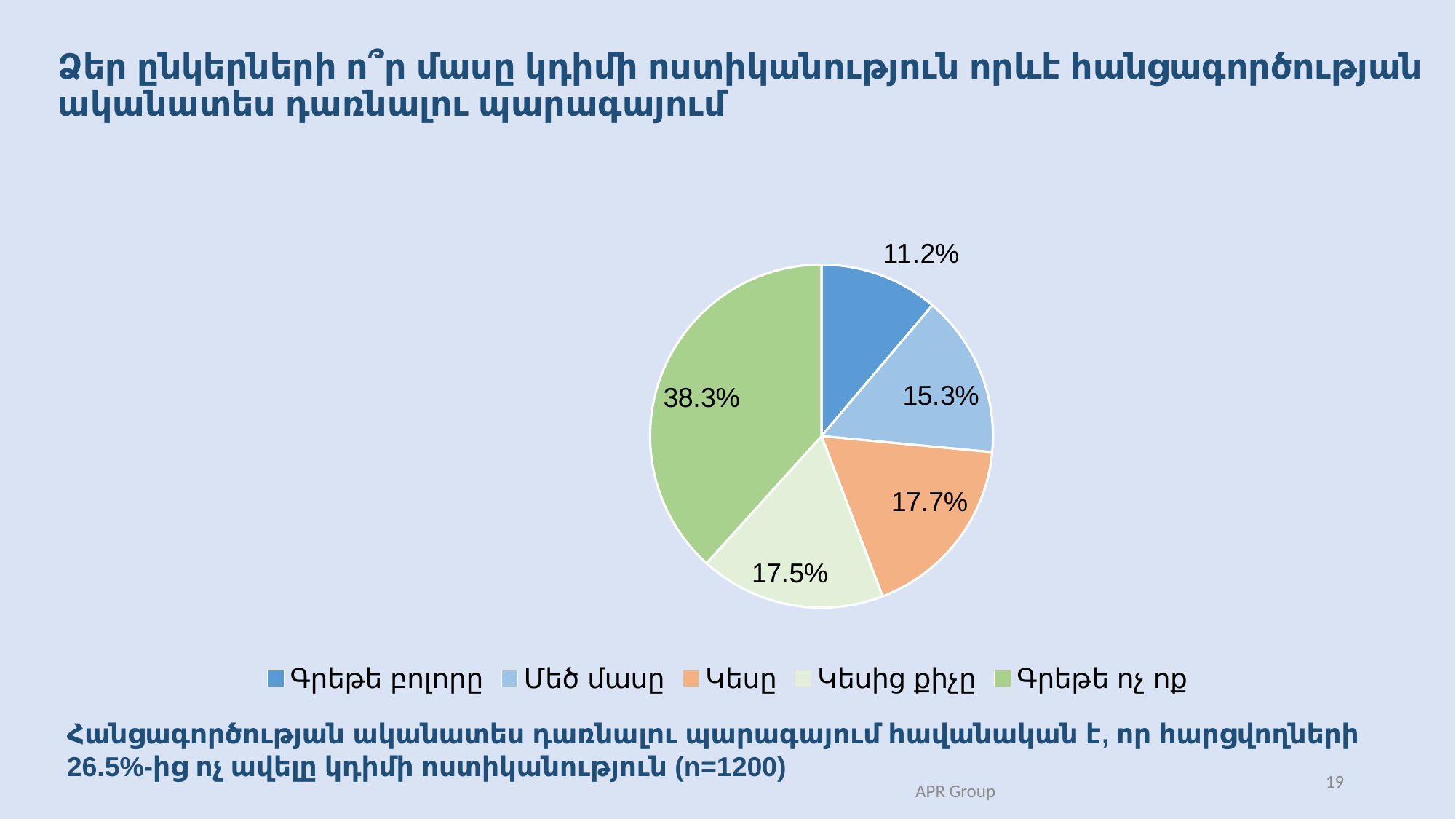
What share of the pie is labelled for Կեսից քիչը? 17.5% What is the difference in percentage points between the Գրեթե ոչ ոք slice and the Գրեթե բոլորը slice? 27.1 How many slices does the pie chart have? 5 What share of the pie is labelled for Մեծ մասը? 15.3% What colour is the Կեսը slice in the pie chart? orange What share of the pie is labelled for Գրեթե բոլորը? 11.2% Which category has the smallest slice of the pie? Գրեթե բոլորը What share of the pie is labelled for Կեսը? 17.7% What share of the pie is labelled for Գրեթե ոչ ոք? 38.3% What kind of chart is shown on the slide? pie chart Which category has the largest slice of the pie? Գրեթե ոչ ոք Which slice is larger, Մեծ մասը or Գրեթե ոչ ոք? Գրեթե ոչ ոք